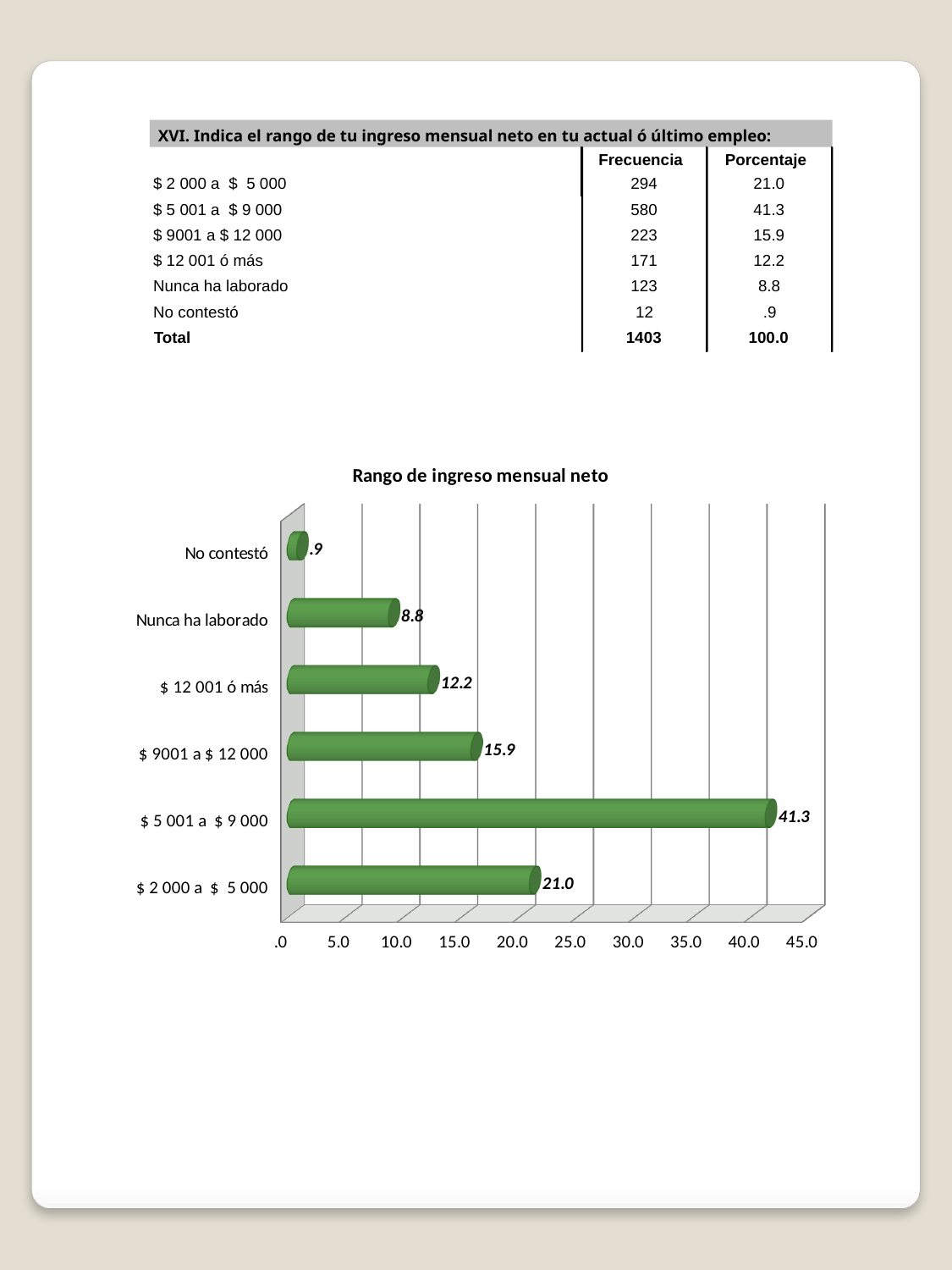
What is the value for "No contestó" in the chart? .9 Is the value for "$ 12 001 ó más" greater or less than 15.0? less What is the difference between the values for "$ 5 001 a $ 9 000" and "$ 2 000 a $ 5 000"? 20.3 What is the difference between the values for "$ 9001 a $ 12 000" and "$ 12 001 ó más"? 3.7 What is the value for "$ 5 001 a $ 9 000" in the chart? 41.3 How many categories are shown in the chart? 6 What is the title of the chart? Rango de ingreso mensual neto Which category has the highest value in the chart? $ 5 001 a $ 9 000 Which category has the lowest value in the chart? No contestó What is the value for "Nunca ha laborado" in the chart? 8.8 What kind of chart is shown on the slide? bar chart Which is larger, the value for "$ 2 000 a $ 5 000" or the value for "$ 9001 a $ 12 000"? $ 2 000 a $ 5 000